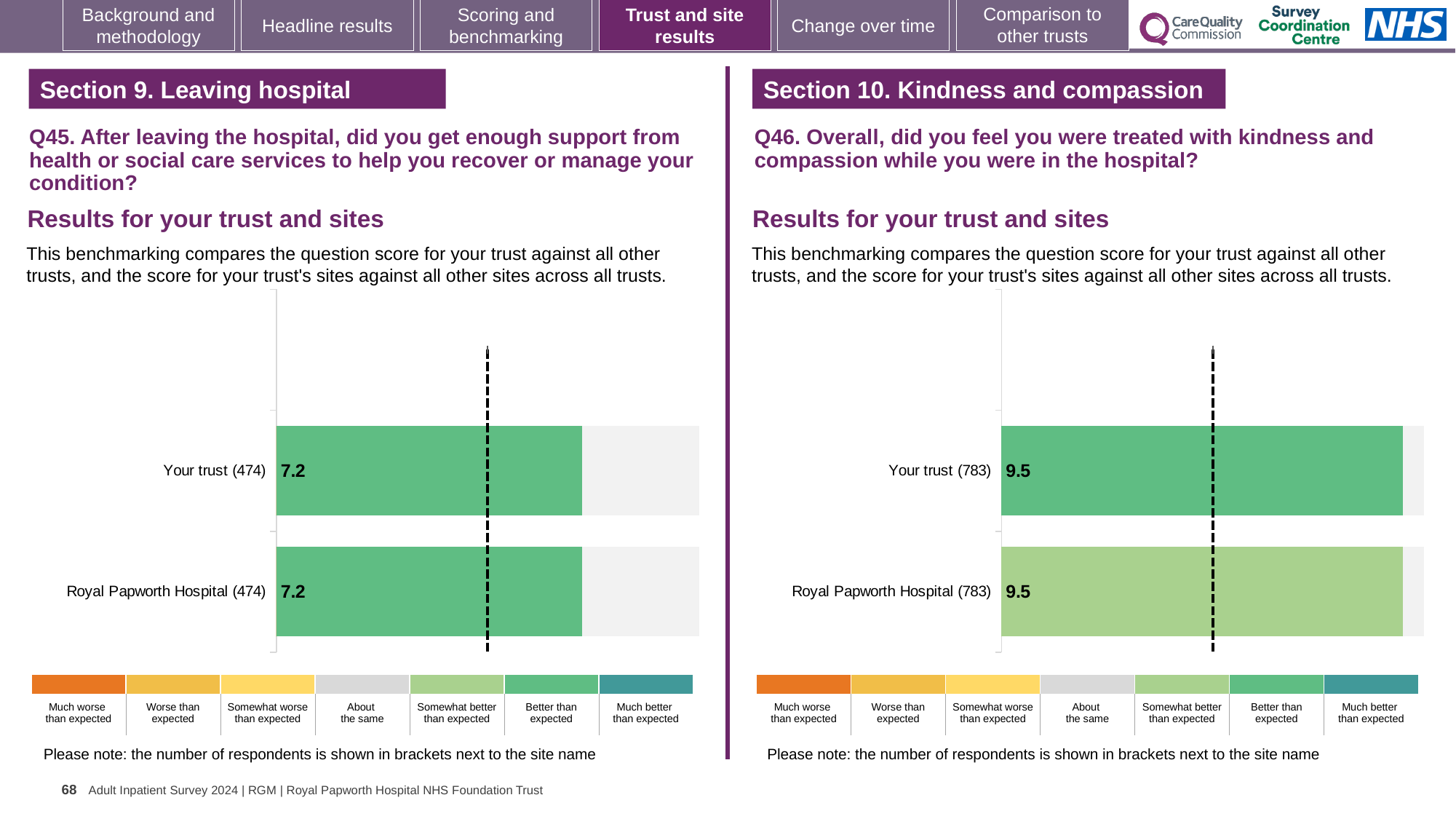
On the Q45 chart (left), what is the difference between the score for Your trust and the score for Royal Papworth Hospital? 0 Is the Your trust score on the Q46 chart (right) larger or smaller than the Your trust score on the Q45 chart (left)? Larger On the Q45 chart (left), how many respondents are shown in brackets next to Your trust? 474 What kind of chart is the Q45 chart (left)? Bar chart On the Q46 chart (right), how many respondents are shown in brackets next to Royal Papworth Hospital? 783 On the Q46 chart (right), what is the score for Your trust? 9.5 On the Q46 chart (right), which benchmark category does the colour of the Royal Papworth Hospital bar correspond to? Somewhat better than expected On the Q45 chart (left), what is the score for Royal Papworth Hospital? 7.2 On the Q45 chart (left), which benchmark category does the colour of the Your trust bar correspond to? Better than expected On the Q46 chart (right), what is the score for Royal Papworth Hospital? 9.5 On the Q46 chart (right), how many bars are plotted? 2 On the Q45 chart (left), what is the score for Your trust? 7.2